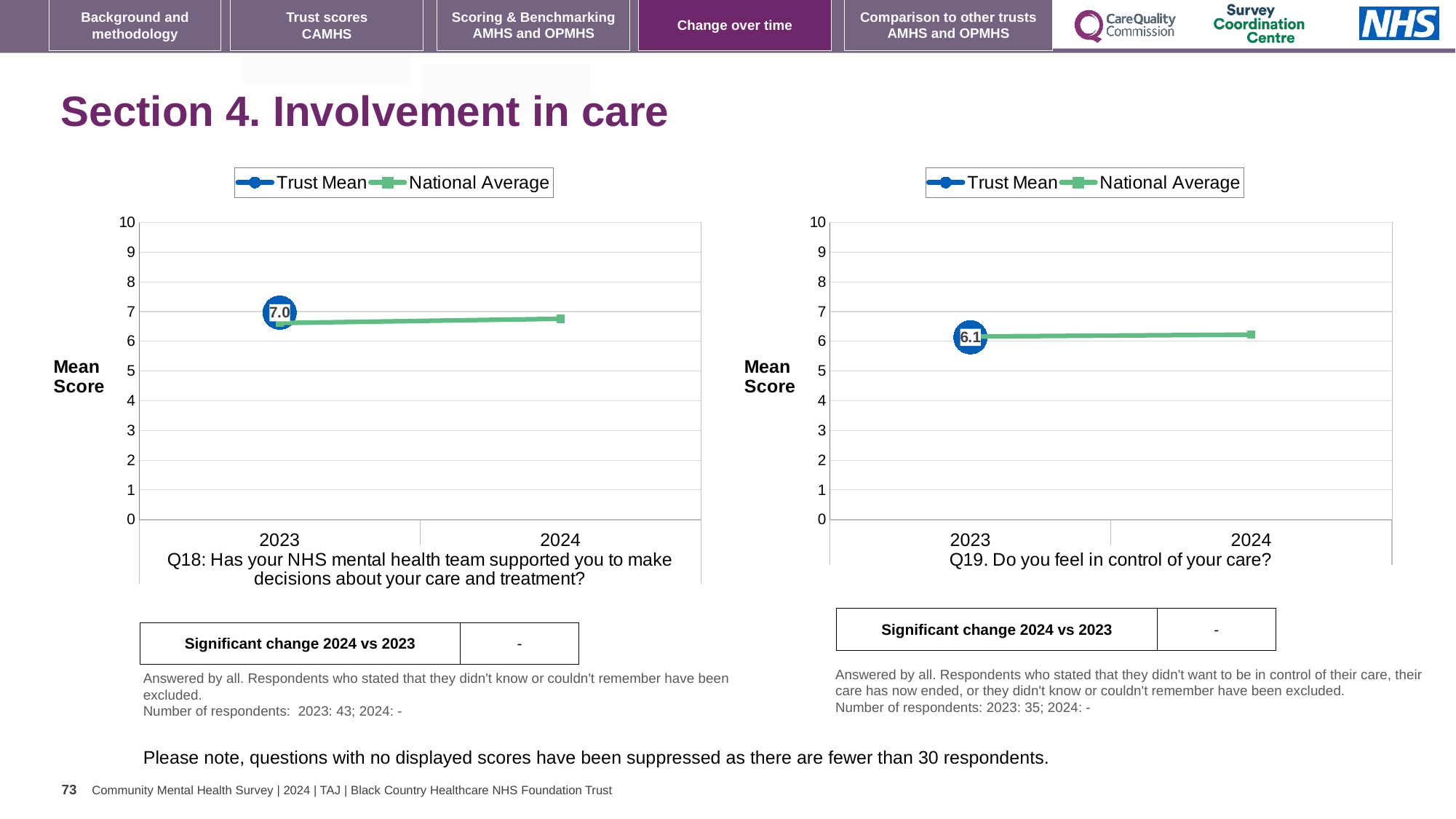
On the Q19 chart (right), is the Trust Mean value for 2023 greater or less than 7? less How many series does the legend list on the Q18 chart (left)? 2 How many years are shown on the x axis of the Q18 chart (left)? 2 On the Q18 chart (left), which is larger for 2023: the Trust Mean or the National Average? Trust Mean What are the two series named in the legend of the Q19 chart (right)? Trust Mean and National Average On the Q18 chart (left), is the National Average value for 2024 greater or less than 7? less What is the y-axis label on the Q18 chart (left)? Mean Score What kind of chart is the Q19 chart (right)? Line chart On the Q19 chart (right), what is the Trust Mean score for 2023? 6.1 On the Q18 chart (left), what is the Trust Mean score for 2023? 7.0 On the Q18 chart (left), is the National Average value for 2024 greater or less than 6? greater